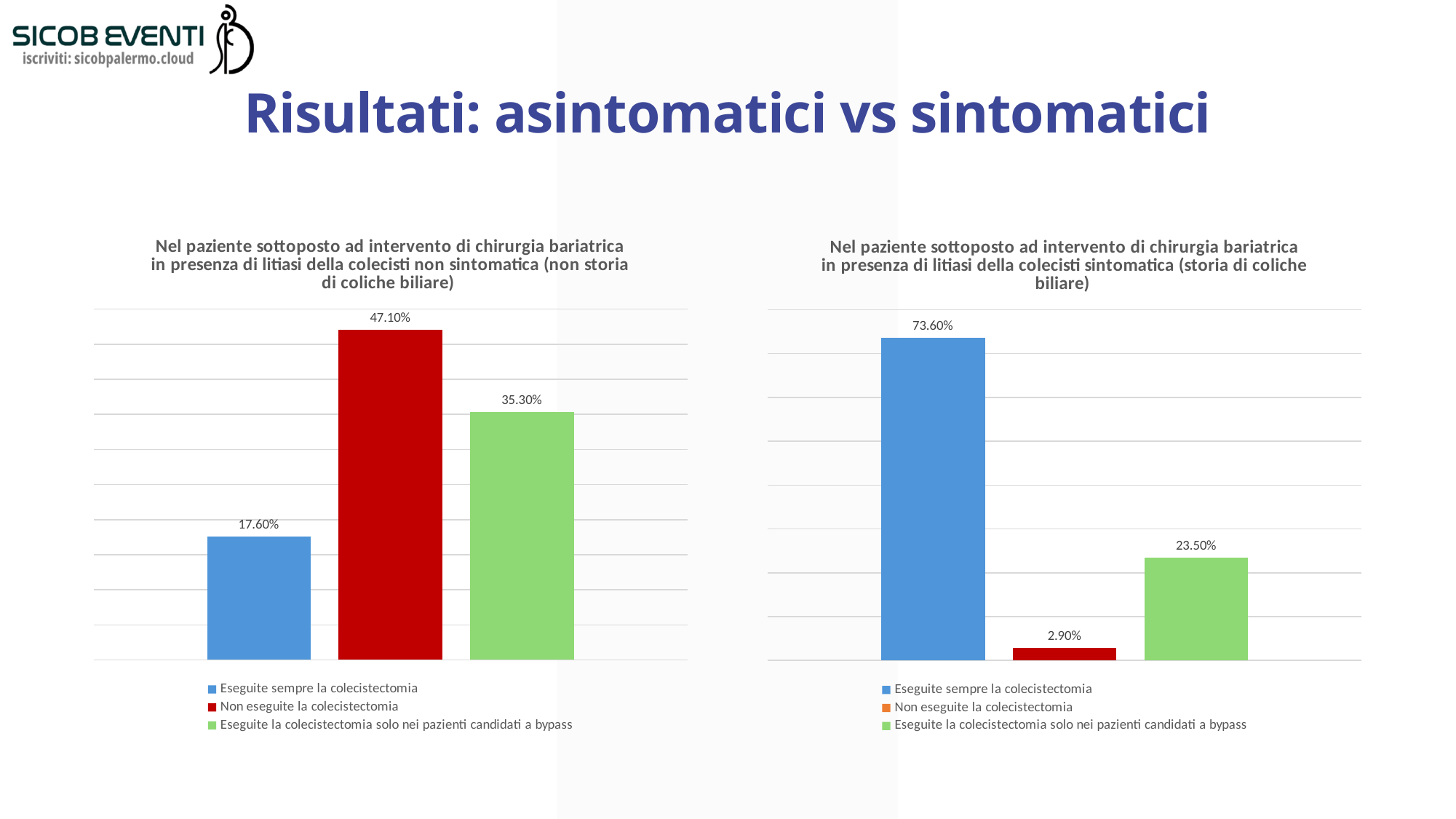
In the left chart (litiasi non sintomatica), what is the value for 'Eseguite sempre la colecistectomia'? 17.60% In the left chart (litiasi non sintomatica), which is larger: 'Eseguite sempre la colecistectomia' or 'Eseguite la colecistectomia solo nei pazienti candidati a bypass'? Eseguite la colecistectomia solo nei pazienti candidati a bypass How many bars are plotted in the right chart (litiasi sintomatica)? 3 In the right chart (litiasi sintomatica), which option has the lowest value? Non eseguite la colecistectomia In the left chart (litiasi non sintomatica), what is the value for 'Non eseguite la colecistectomia'? 47.10% In the right chart (litiasi sintomatica), what is the difference between 'Eseguite sempre la colecistectomia' and 'Non eseguite la colecistectomia'? 70.70% In the left chart (litiasi non sintomatica), what is the difference between 'Non eseguite la colecistectomia' and 'Eseguite la colecistectomia solo nei pazienti candidati a bypass'? 11.80% In the right chart (litiasi sintomatica), what is the value for 'Eseguite sempre la colecistectomia'? 73.60% In the left chart (litiasi non sintomatica), which option has the highest value? Non eseguite la colecistectomia In the right chart (litiasi sintomatica), what is the value for 'Eseguite la colecistectomia solo nei pazienti candidati a bypass'? 23.50% How many entries does the legend of the left chart (litiasi non sintomatica) list? 3 What type of chart is the left chart (litiasi non sintomatica)? Bar chart